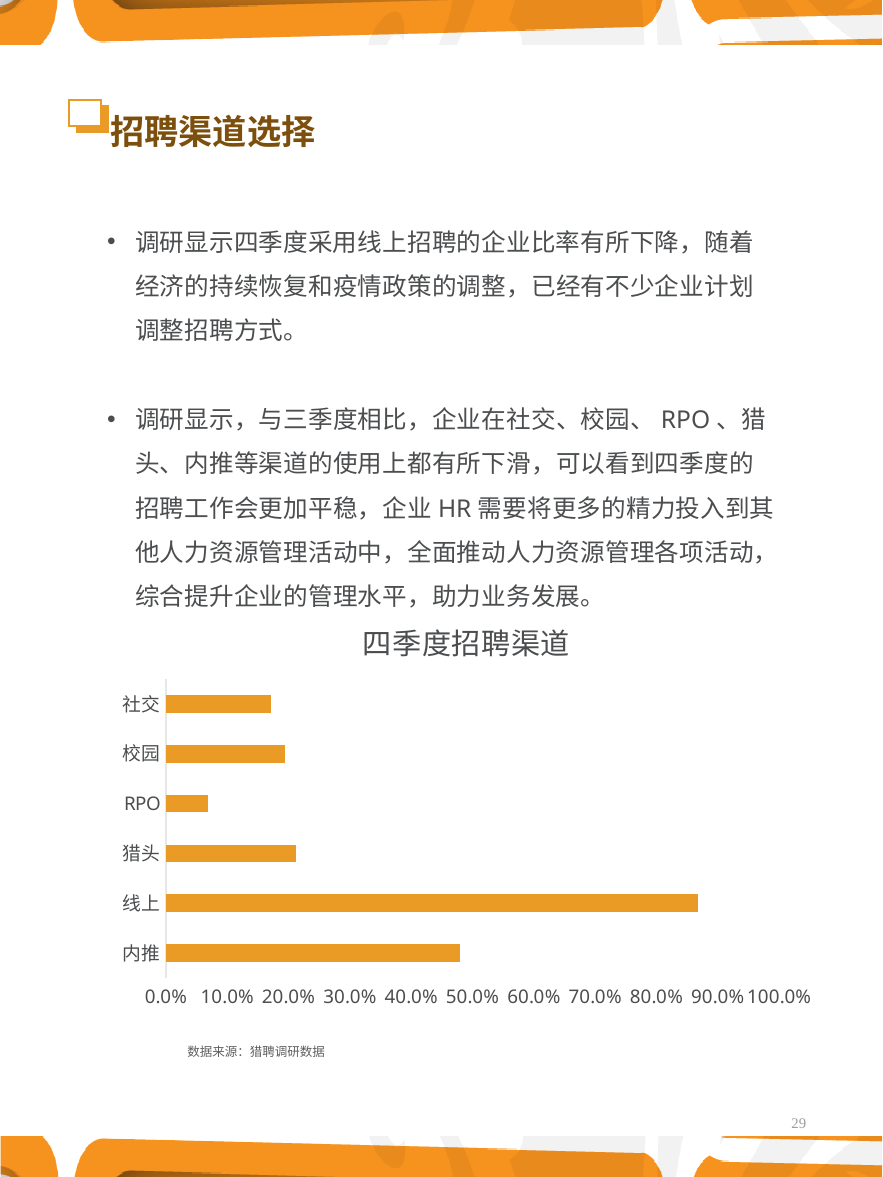
Which has a larger value, 线上 or 内推? 线上 Which has a larger value, 内推 or 猎头? 内推 What is the title of the chart? 四季度招聘渠道 Is the value for RPO greater or less than 10.0%? less Which has a larger value, 社交 or RPO? 社交 Is the value for 猎头 greater or less than 30.0%? less What kind of chart is shown on the slide? bar chart Which recruitment channel has the highest value in the chart? 线上 Is the value for 内推 greater or less than 40.0%? greater How many recruitment channels (categories) are shown in the chart? 6 Which recruitment channel has the lowest value in the chart? RPO